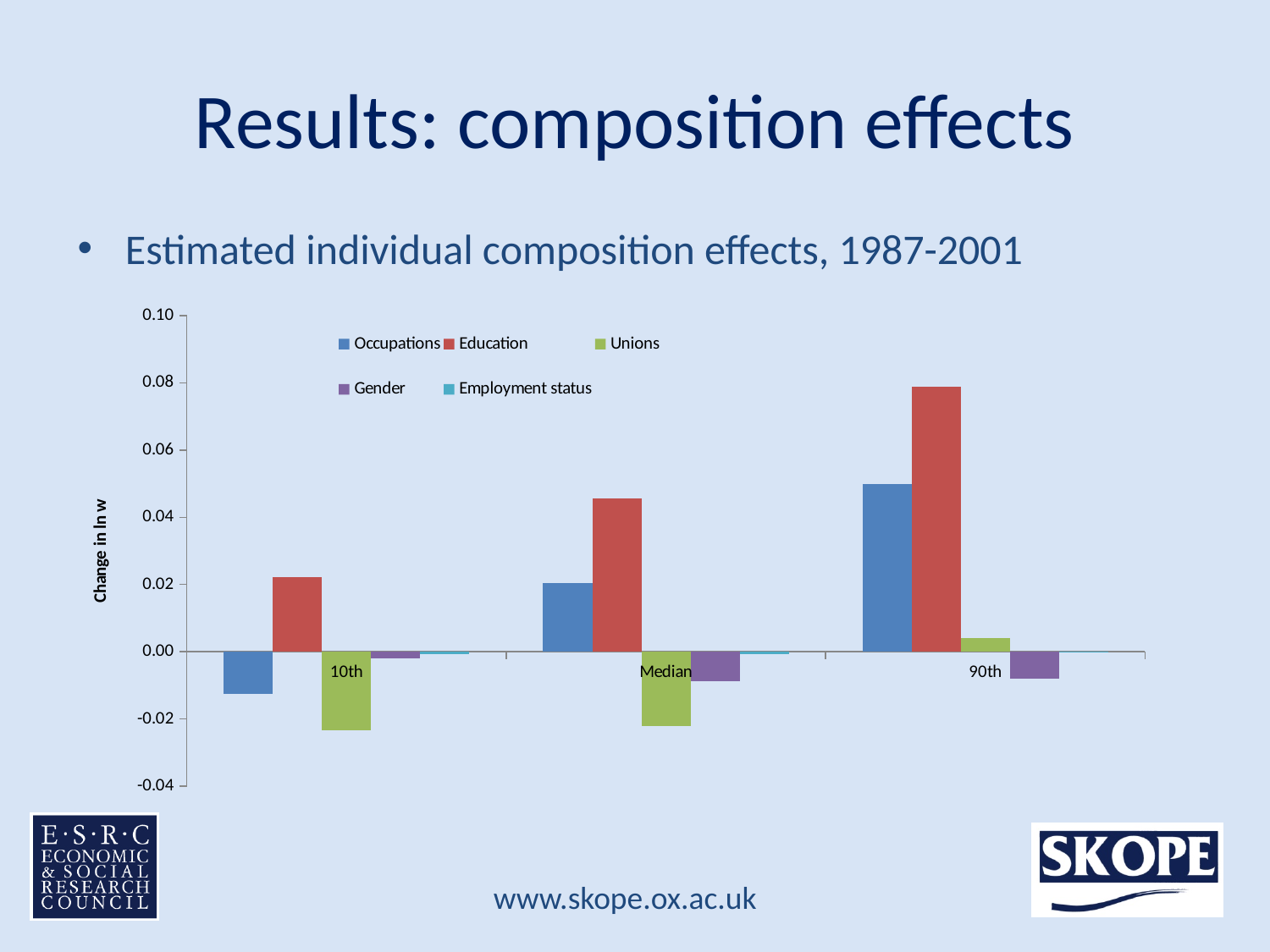
Is the value for Education at the 90th percentile greater or less than 0.06? greater What kind of chart is shown on the slide? bar chart Which series has the lowest value at the 10th percentile? Unions How many categories are shown on the x axis? 3 Do the Education values rise or fall moving from the 10th percentile to the 90th percentile? rise In which category is the Education bar the highest? 90th How many series does the legend list? 5 What is the label on the vertical axis? Change in ln w Which is larger, the Occupations value at the Median or at the 90th percentile? 90th Which series has the highest value at the 90th percentile? Education Is the value for Occupations at the 90th percentile greater or less than 0.06? less Is the value for Occupations at the 10th percentile greater or less than 0.00? less